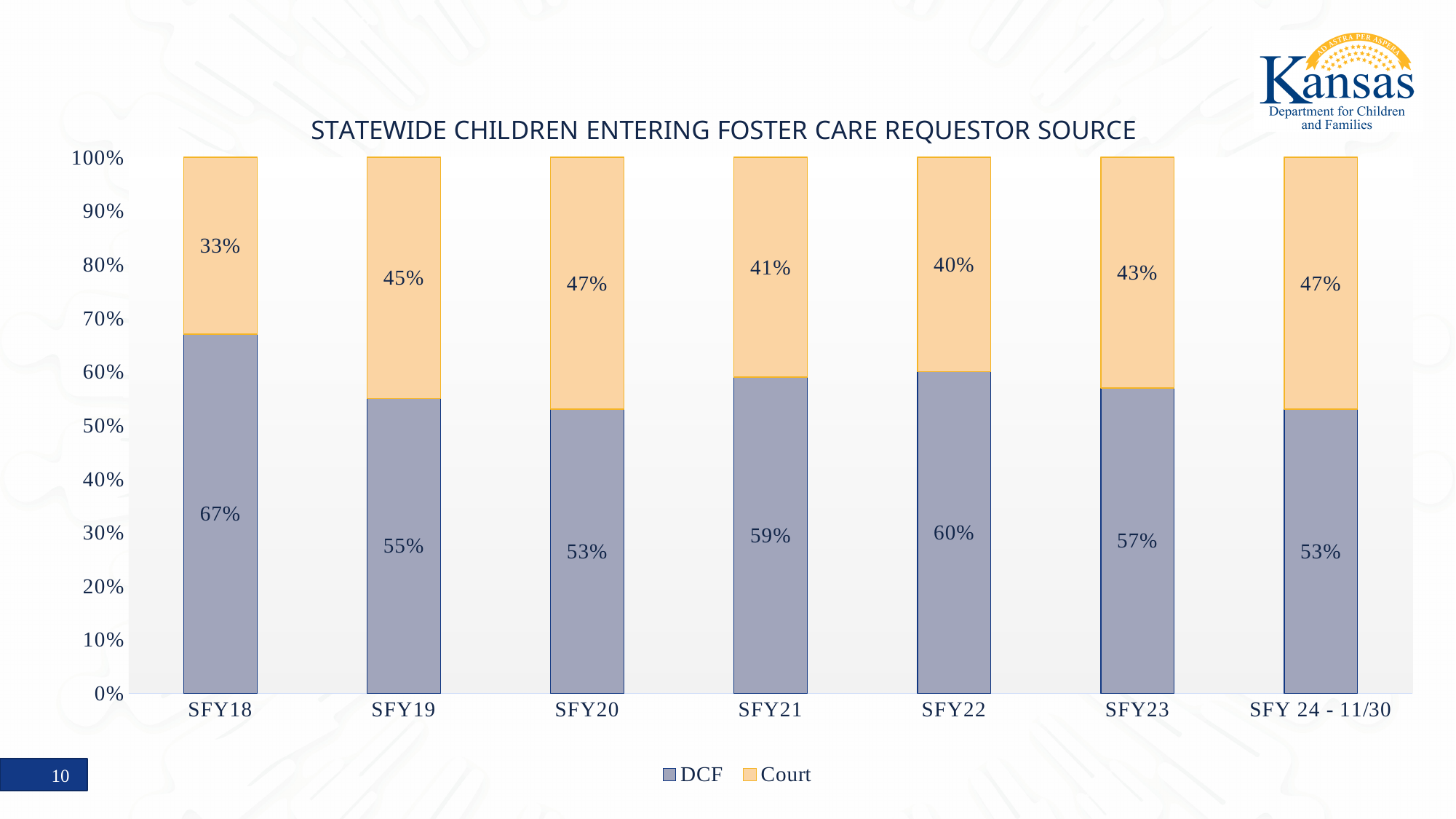
What is the title of the chart? STATEWIDE CHILDREN ENTERING FOSTER CARE REQUESTOR SOURCE Which is larger for SFY23, the DCF value or the Court value? DCF Which category has the lowest Court value? SFY18 What is the difference between the DCF and Court values for SFY21? 18% What kind of chart is shown on the slide? Stacked bar chart What is the DCF value for SFY 24 - 11/30? 53% What is the DCF value for SFY18? 67% Which category has the highest DCF value? SFY18 How many series does the legend list? 2 What is the Court value for SFY20? 47% What is the Court value for SFY22? 40% How many categories are shown on the x axis? 7